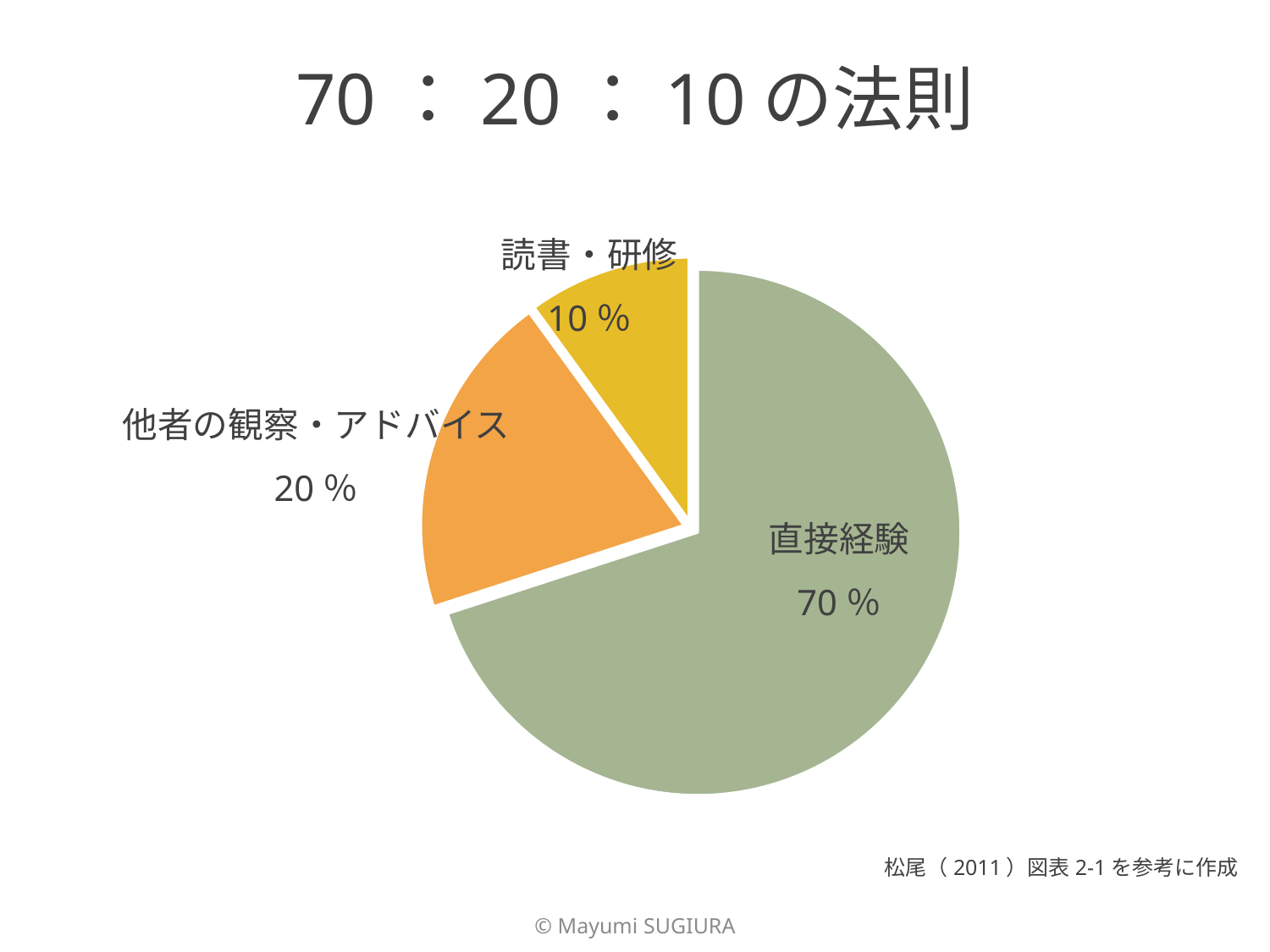
Which category has the largest share of the pie? 直接経験 What is the difference between the values for 他者の観察・アドバイス and 読書・研修? 10 % Which is larger, the value for 他者の観察・アドバイス or the value for 読書・研修? 他者の観察・アドバイス What is the value for 他者の観察・アドバイス? 20 % What is the value for 読書・研修? 10 % How many slices does the pie chart have? 3 What is the difference between the values for 直接経験 and 他者の観察・アドバイス? 50 % What colour is the slice for 直接経験? green What is the title of the slide? 70：20：10 の法則 What kind of chart is shown on the slide? pie chart Which category has the smallest share of the pie? 読書・研修 What is the value for 直接経験? 70 %